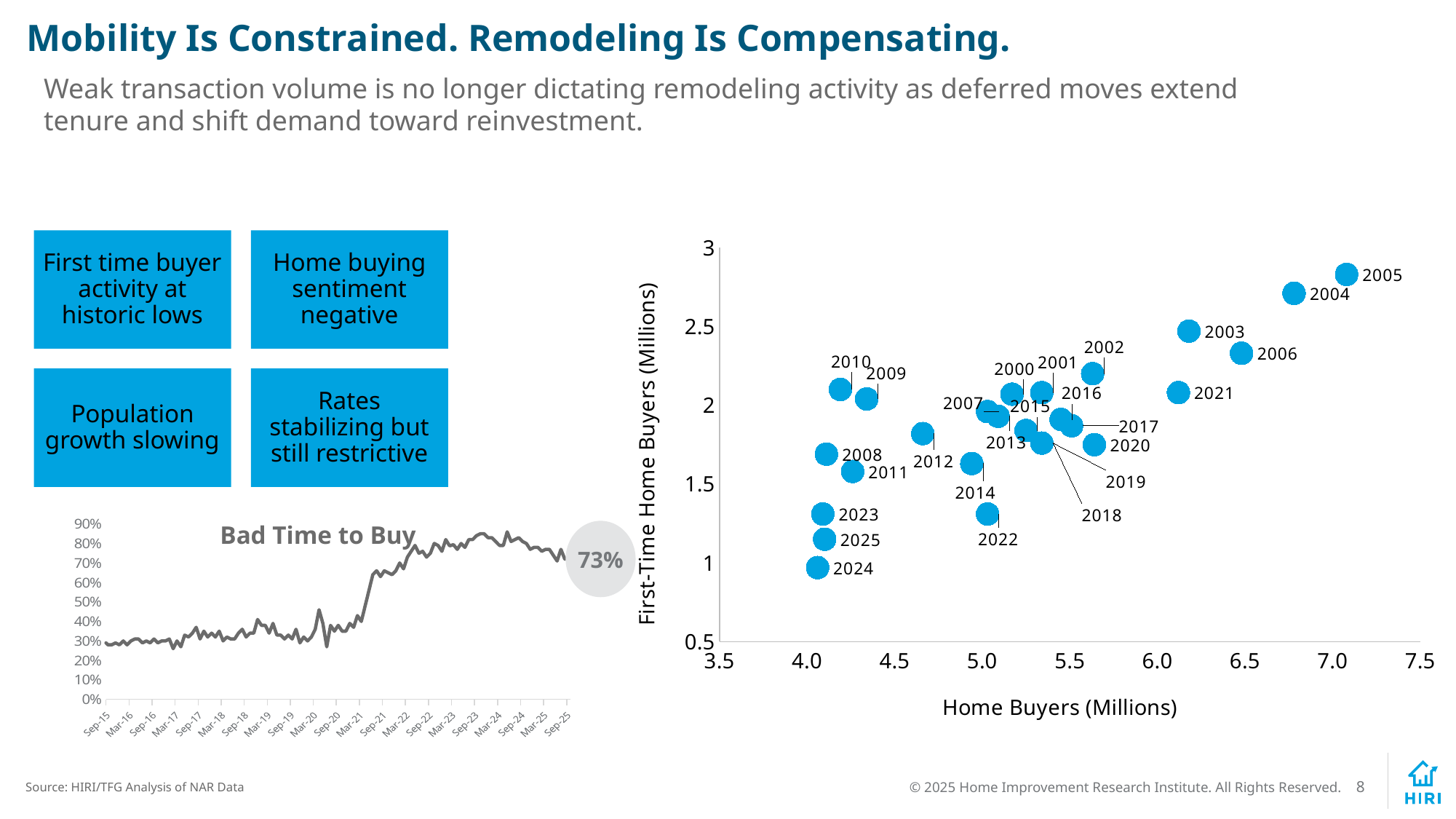
On the scatter chart on the right, how many data points (years) are plotted? 26 On the scatter chart on the right, what is the label of the x axis? Home Buyers (Millions) On the 'Bad Time to Buy' chart on the left, does the line generally rise or fall from Sep-15 to Sep-25? rise On the scatter chart on the right, is the first-time home buyers value for 2005 greater or less than 2.5 million? greater On the 'Bad Time to Buy' chart on the left, what is the value shown at the end of the line? 73% On the scatter chart on the right, is the first-time home buyers value for 2022 greater or less than 1.5 million? less On the scatter chart on the right, what kind of chart is it? scatter chart On the scatter chart on the right, which year has more first-time home buyers, 2003 or 2006? 2003 On the scatter chart on the right, which year has more first-time home buyers, 2010 or 2011? 2010 On the scatter chart on the right, which year has the highest number of first-time home buyers? 2005 On the scatter chart on the right, is the home buyers value for 2004 greater or less than 6.5 million? greater On the scatter chart on the right, which year has the lowest number of first-time home buyers? 2024